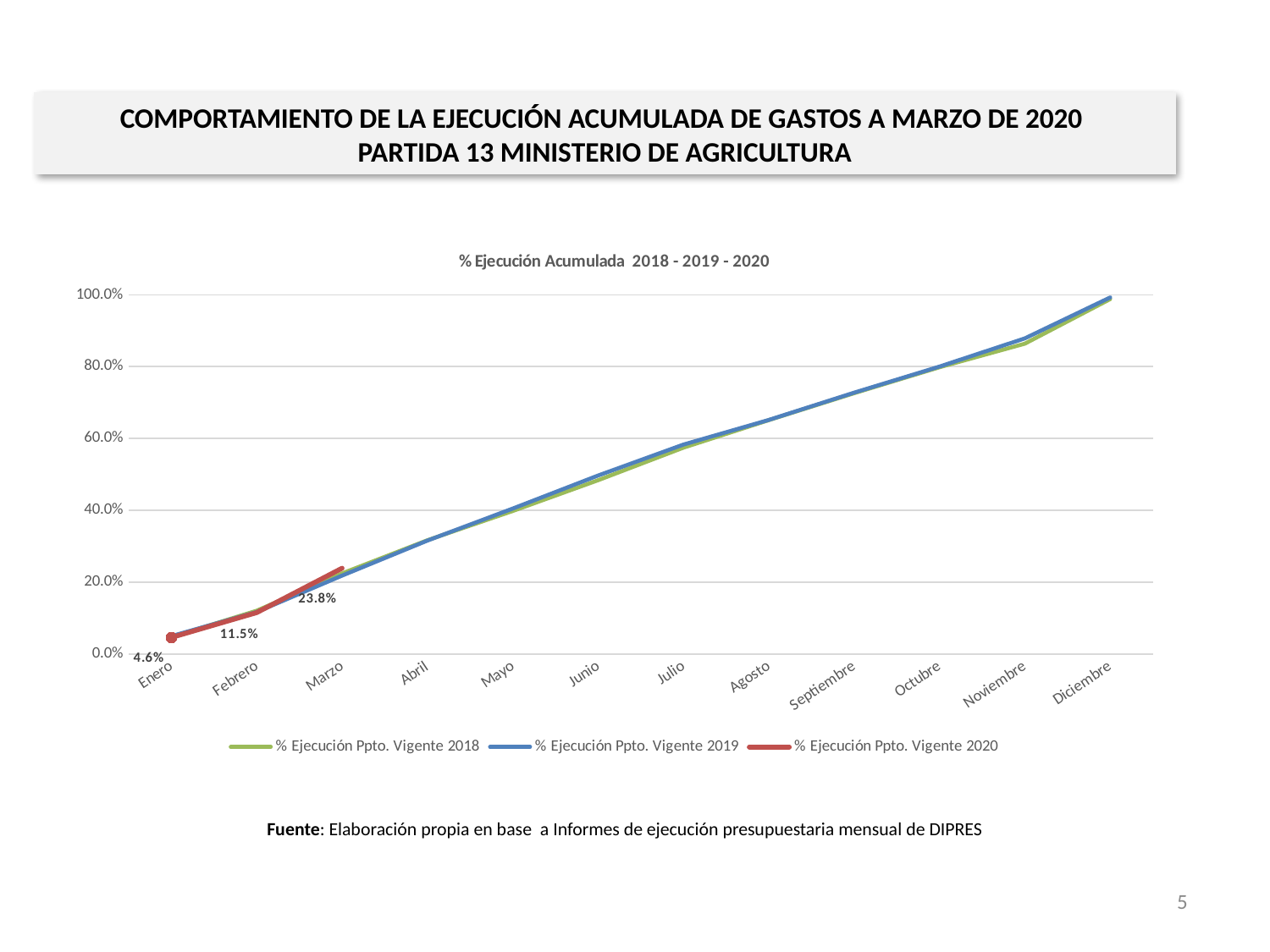
What is the value of % Ejecución Ppto. Vigente 2020 for Febrero? 11.5% Do the values of the 2019 series rise or fall from Enero to Diciembre? Rise What is the title of the chart? % Ejecución Acumulada 2018 - 2019 - 2020 Is the value of % Ejecución Ppto. Vigente 2019 for Diciembre greater or less than 80%? greater What is the difference between the 2020 values for Febrero and Enero? 6.9% What kind of chart is shown on the slide? Line chart What is the difference between the 2020 values for Marzo and Febrero? 12.3% Which is larger for the 2020 series: the value for Marzo or the value for Febrero? Marzo How many months are shown on the x axis? 12 What is the value of % Ejecución Ppto. Vigente 2020 for Marzo? 23.8% How many series does the legend list? 3 What is the value of % Ejecución Ppto. Vigente 2020 for Enero? 4.6%